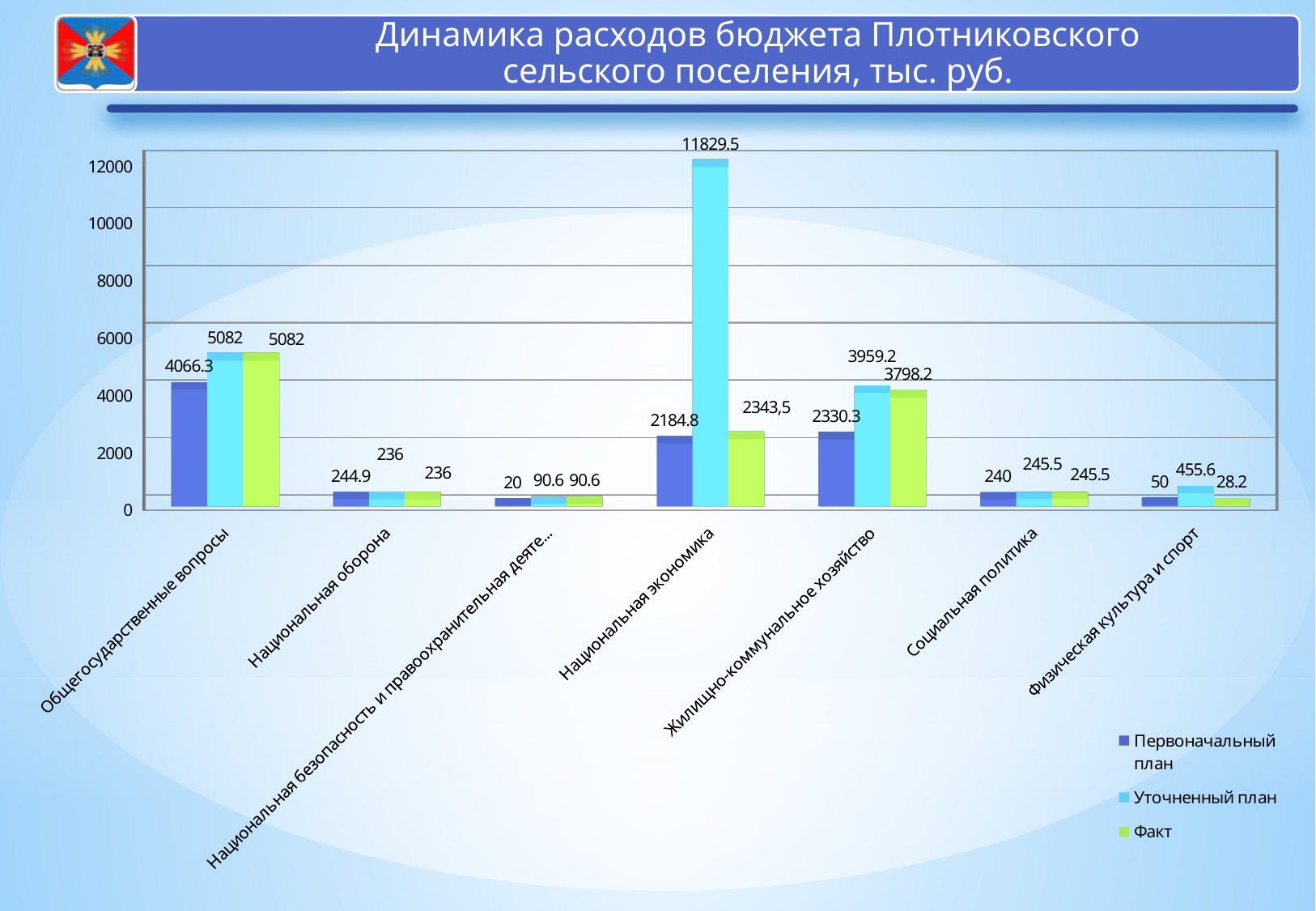
Which is larger for Физическая культура и спорт: the Первоначальный план value or the Факт value? Первоначальный план What is the title of the chart? Динамика расходов бюджета Плотниковского сельского поселения, тыс. руб. What kind of chart is shown on the slide? Bar chart Which category has the lowest Первоначальный план value? Национальная безопасность и правоохранительная деяте... What is the Уточненный план value for Физическая культура и спорт? 455.6 What is the Уточненный план value for Национальная экономика? 11829.5 Which category has the highest Уточненный план value? Национальная экономика What is the Первоначальный план value for Общегосударственные вопросы? 4066.3 What is the difference between the Уточненный план and Факт values for Жилищно-коммунальное хозяйство? 161 How many series does the legend list? 3 How many categories are shown on the x axis? 7 What is the Факт value for Жилищно-коммунальное хозяйство? 3798.2